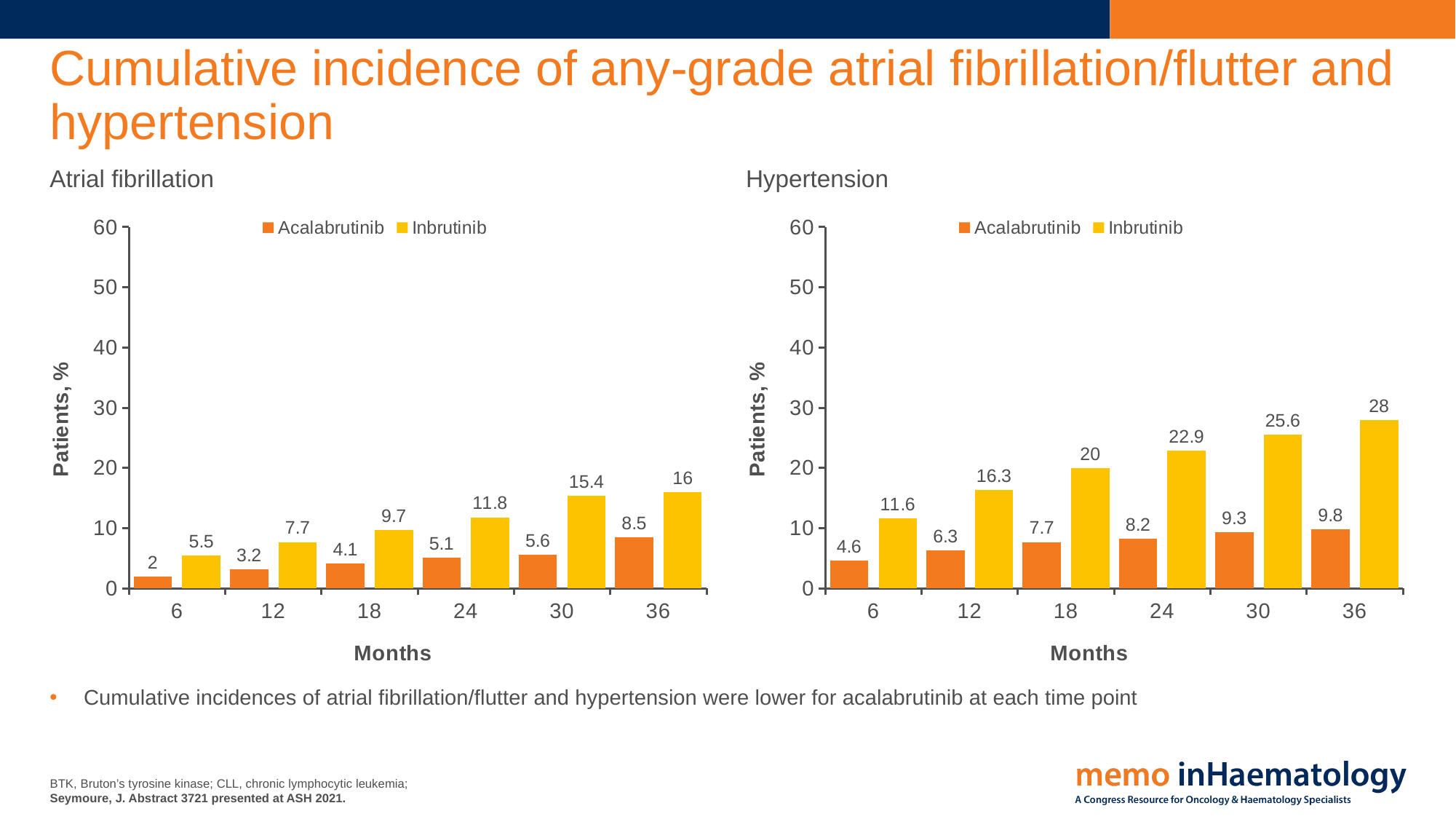
In the Atrial fibrillation chart, what is the value for Ibrutinib at 36 months? 16 In the Hypertension chart, what is the difference between Ibrutinib and Acalabrutinib at 36 months? 18.2 How many series does the legend of the Atrial fibrillation chart list? 2 In the Hypertension chart, what is the value for Acalabrutinib at 6 months? 4.6 In the Hypertension chart, do the Ibrutinib values rise or fall from 6 to 36 months? rise How many time points are shown on the x axis of the Hypertension chart? 6 In the Atrial fibrillation chart, which is larger at 30 months, Acalabrutinib or Ibrutinib? Ibrutinib In the Hypertension chart, at which month is the Ibrutinib value highest? 36 In the Atrial fibrillation chart, what is the value for Acalabrutinib at 12 months? 3.2 In the Atrial fibrillation chart, what is the difference between Ibrutinib and Acalabrutinib at 24 months? 6.7 In the Atrial fibrillation chart, at which month is the Acalabrutinib value lowest? 6 In the Hypertension chart, what is the value for Ibrutinib at 24 months? 22.9